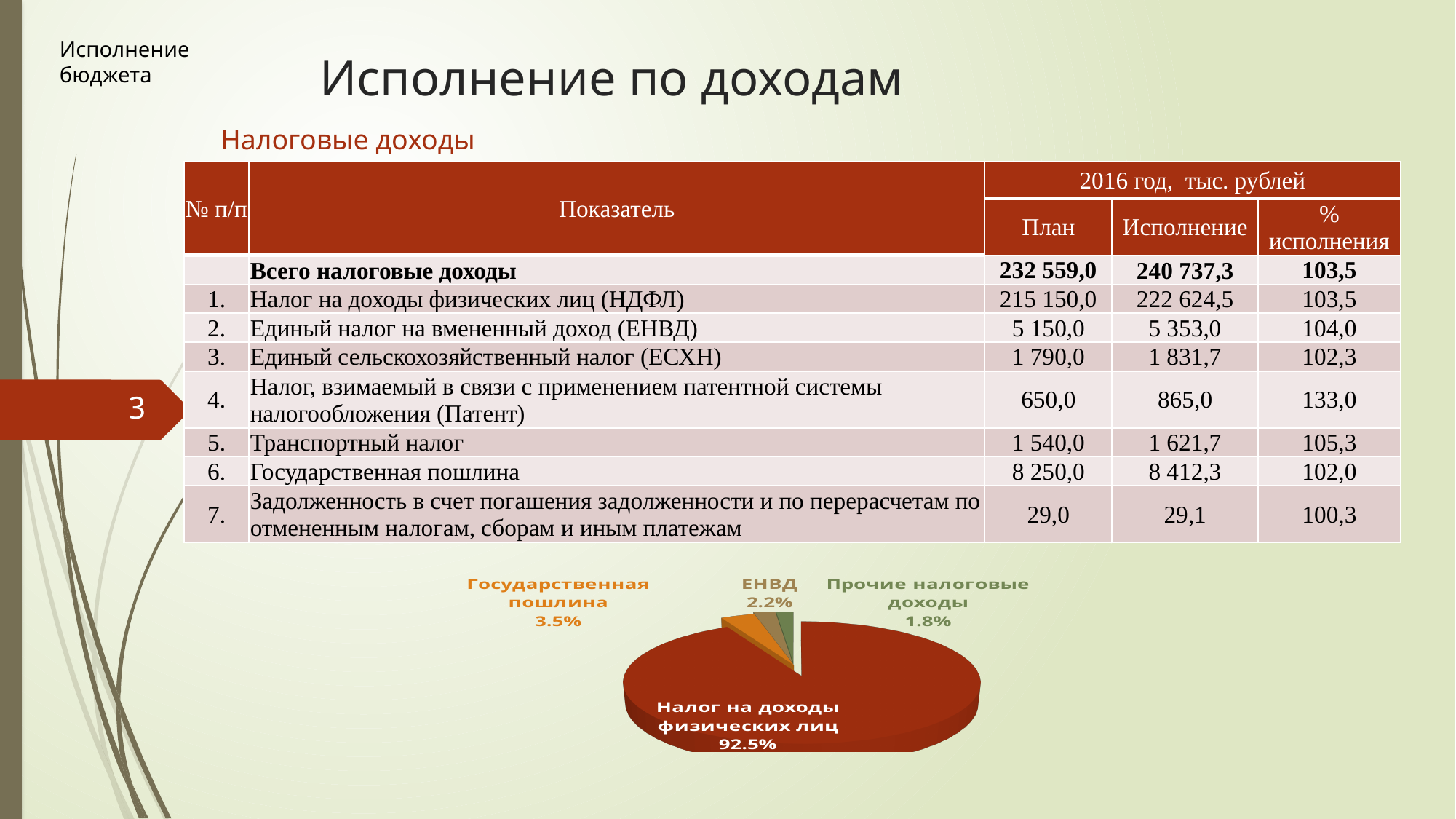
In the pie chart, which is larger: Государственная пошлина or ЕНВД? Государственная пошлина How many slices does the pie chart have? 4 What share of the pie chart does Государственная пошлина have? 3.5% What colour is the largest slice of the pie chart? dark red What share of the pie chart does Прочие налоговые доходы have? 1.8% In the pie chart, what is the difference between the shares of ЕНВД and Прочие налоговые доходы? 0.4% What kind of chart is shown at the bottom of the slide? pie chart In the pie chart, what is the difference between the shares of Государственная пошлина and ЕНВД? 1.3% What share of the pie chart does ЕНВД have? 2.2% Which slice of the pie chart is the largest? Налог на доходы физических лиц Which slice of the pie chart is the smallest? Прочие налоговые доходы